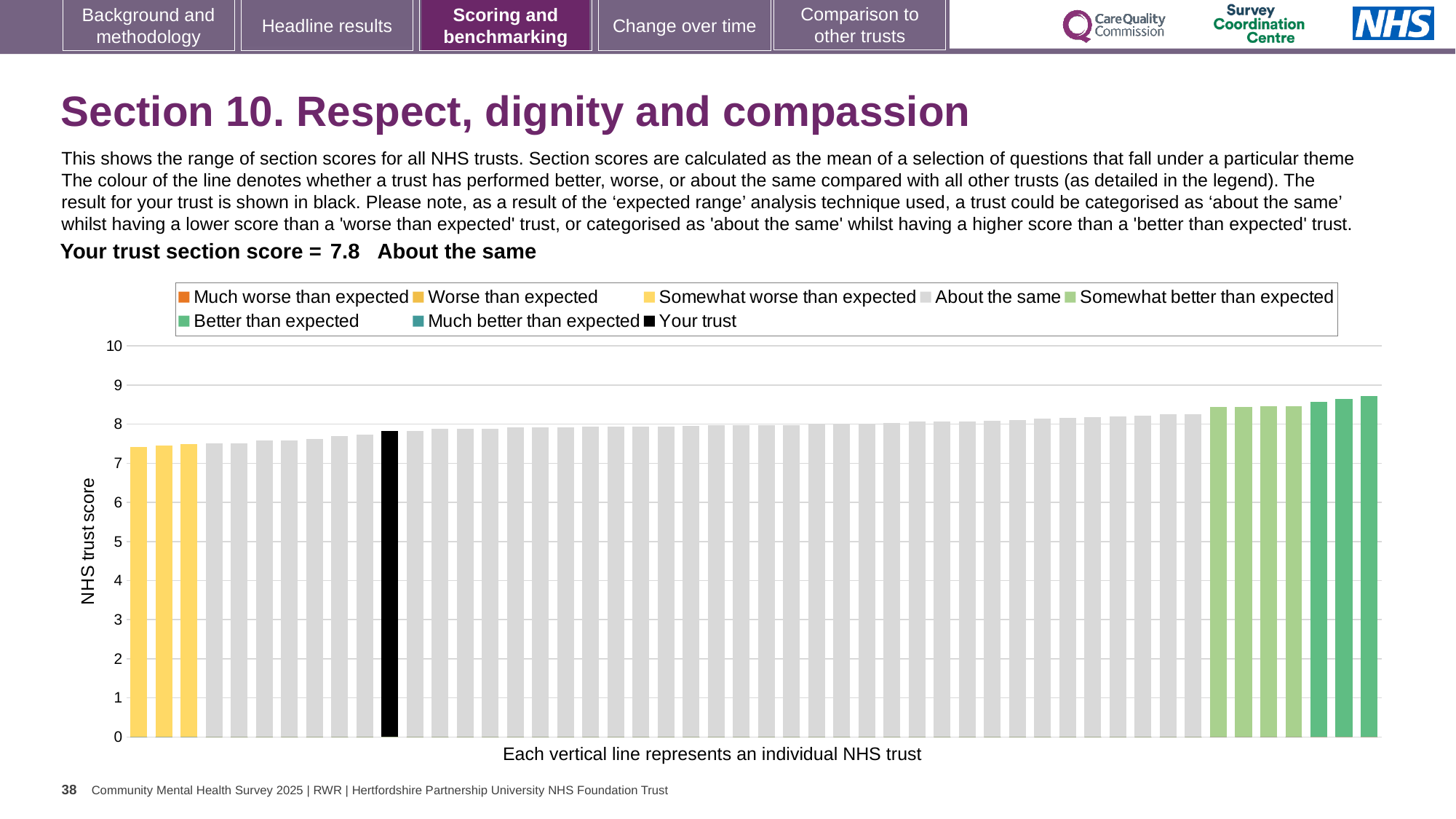
How many entries does the chart legend list? 8 What kind of chart is shown on the slide? bar chart Is the value of the shortest bar in the chart greater or less than 7? greater Which legend category do the tallest bars on the right of the chart belong to? Better than expected What is the label on the vertical axis of the chart? NHS trust score Is the value of the tallest bar in the chart greater or less than 9? less How many bars are coloured yellow (Somewhat worse than expected)? 3 Is the value for the black 'Your trust' bar greater or less than 7? greater How many bars are coloured green (Somewhat better than expected and Better than expected combined)? 7 What is the section score for your trust shown on the slide? 7.8 Do the bar values rise or fall from left to right along the x axis? rise How many bars are coloured orange (Much worse than expected)? 0